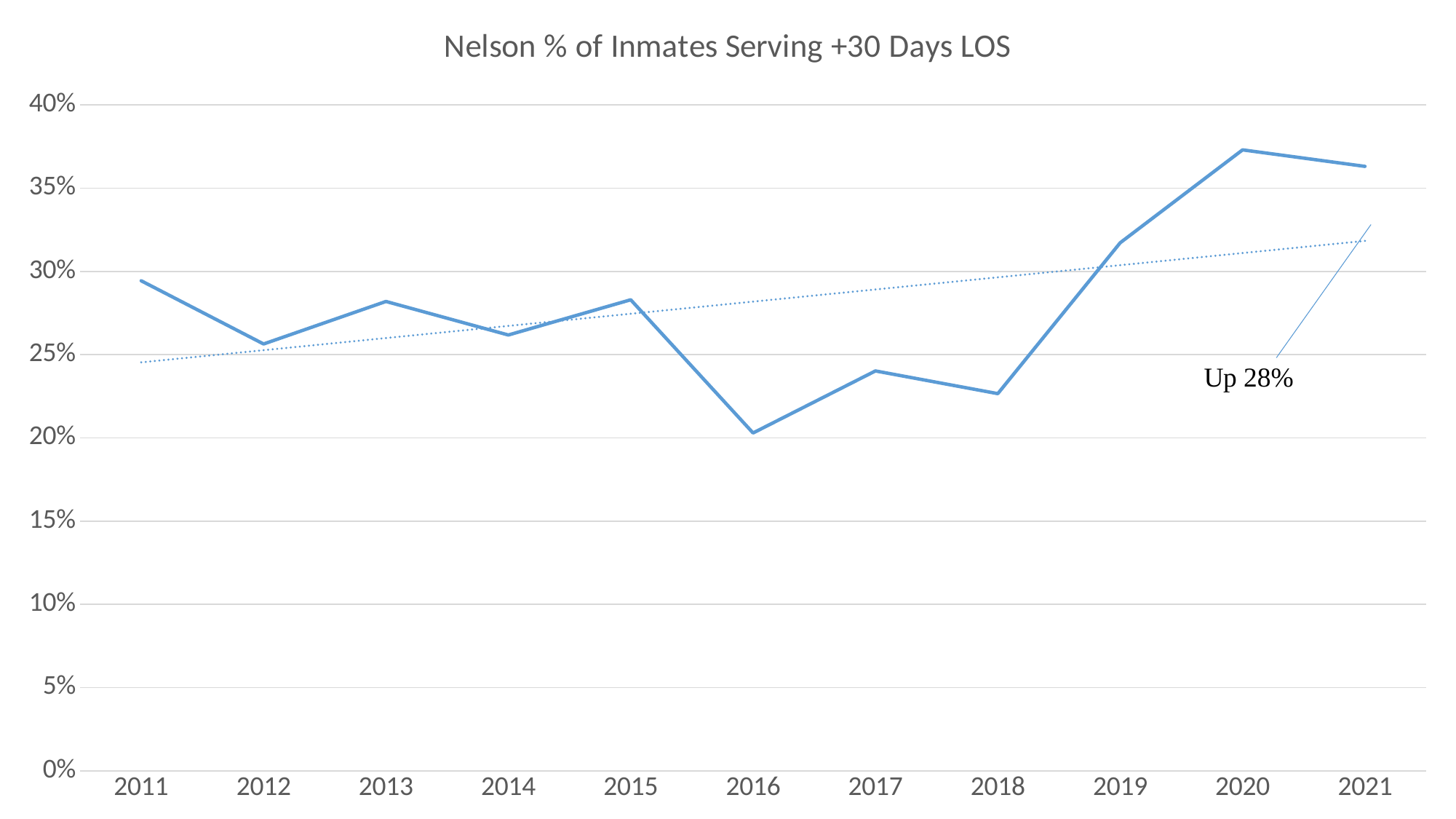
Is the value for 2019 greater or less than 30%? greater Is the value for 2018 greater or less than 25%? less What type of chart is shown on the slide? line chart Which year has the highest percentage of inmates serving +30 days LOS? 2020 What does the text annotation next to the dotted trend line say? Up 28% How many years are plotted along the x axis? 11 Is the value for 2016 greater or less than 25%? less Which year has the larger value, 2016 or 2021? 2021 Which year has the lowest percentage of inmates serving +30 days LOS? 2016 Which year has the larger value, 2011 or 2012? 2011 What is the title of the chart? Nelson % of Inmates Serving +30 Days LOS